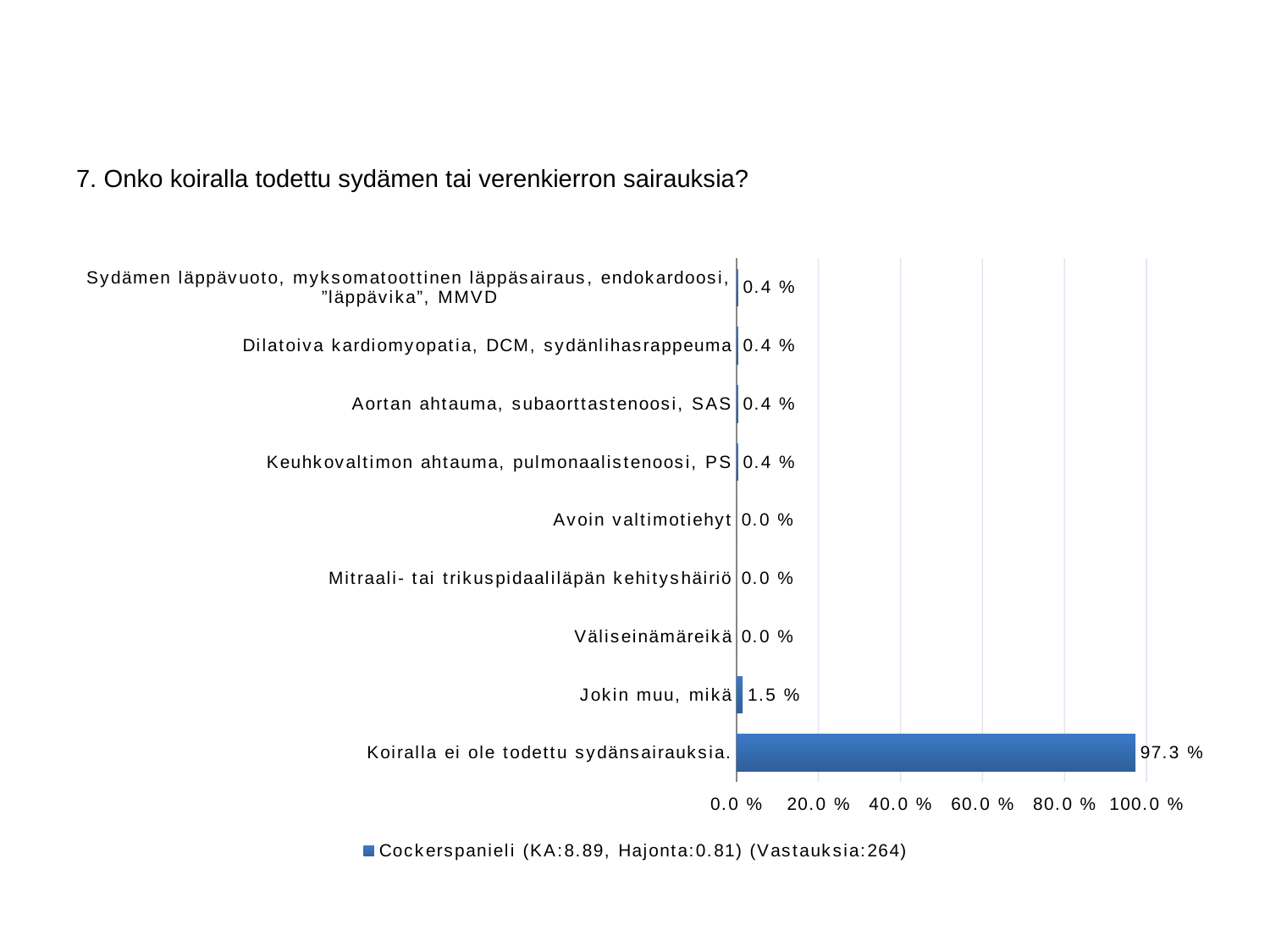
How many series does the legend list? 1 What is the value for "Väliseinämäreikä"? 0.0 % Which category has the highest value? Koiralla ei ole todettu sydänsairauksia. What is the title of the chart? 7. Onko koiralla todettu sydämen tai verenkierron sairauksia? Is the value for "Koiralla ei ole todettu sydänsairauksia." greater or less than 80.0 %? greater What is the difference between the values for "Koiralla ei ole todettu sydänsairauksia." and "Jokin muu, mikä"? 95.8 % How many categories are shown in the chart? 9 What is the value for "Koiralla ei ole todettu sydänsairauksia."? 97.3 % What kind of chart is shown on the slide? bar chart Which is larger, the value for "Jokin muu, mikä" or the value for "Keuhkovaltimon ahtauma, pulmonaalistenoosi, PS"? Jokin muu, mikä What is the value for "Aortan ahtauma, subaorttastenoosi, SAS"? 0.4 % What is the value for "Jokin muu, mikä"? 1.5 %